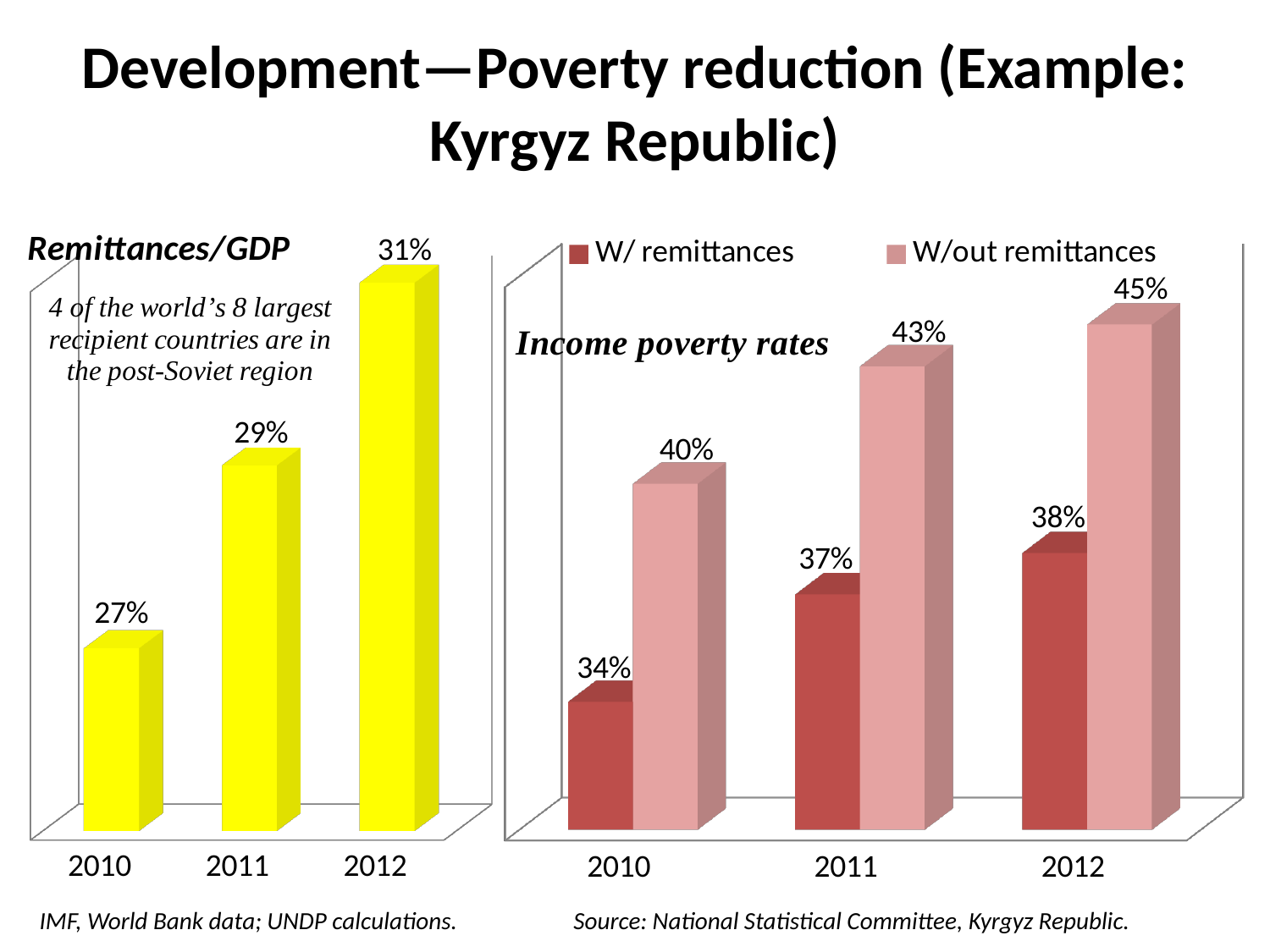
In the Remittances/GDP chart, which year has the highest value? 2012 In the Income poverty rates chart, which is larger for 2010: W/ remittances or W/out remittances? W/out remittances In the Income poverty rates chart, what is the W/out remittances value for 2011? 43% In the Income poverty rates chart, which year has the lowest W/ remittances value? 2010 What kind of chart is the Income poverty rates chart? bar chart How many series does the legend of the Income poverty rates chart list? 2 In the Remittances/GDP chart, what is the difference between the 2012 and 2010 values? 4% In the Income poverty rates chart, what is the W/ remittances value for 2010? 34% In the Remittances/GDP chart, how many years are shown? 3 In the Remittances/GDP chart, what is the value for 2011? 29% In the Income poverty rates chart, what is the difference between the W/out remittances and W/ remittances values for 2012? 7% In the Remittances/GDP chart, do the values rise or fall from 2010 to 2012? rise